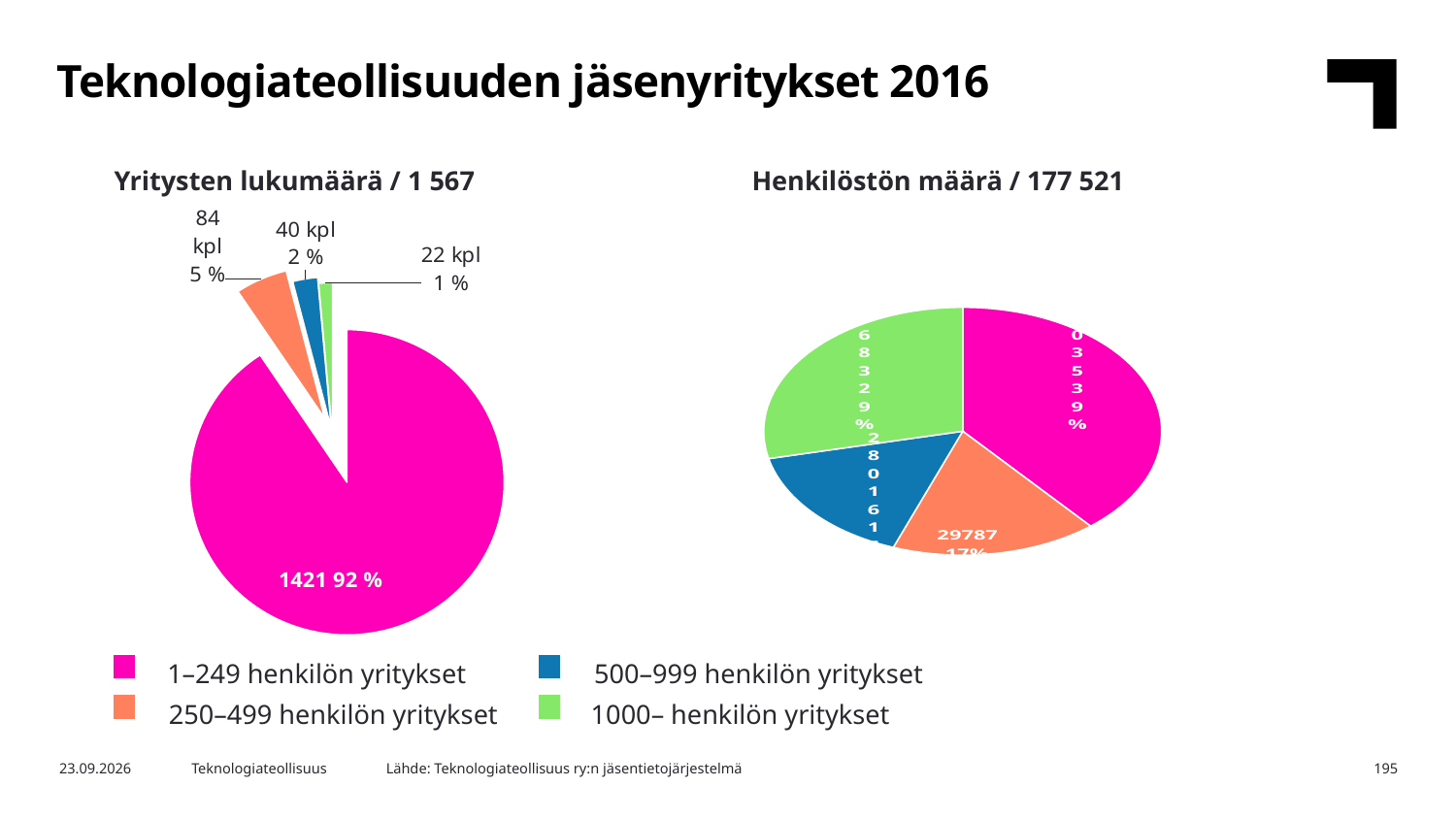
How many slices does the left chart 'Yritysten lukumäärä / 1 567' have? 4 In the left chart 'Yritysten lukumäärä / 1 567', what share of the pie does the 1000– henkilön yritykset slice have? 1 % In the left chart 'Yritysten lukumäärä / 1 567', how many companies are in the 1–249 henkilön yritykset category? 1421 How many categories does the shared legend below the charts list? 4 In the left chart 'Yritysten lukumäärä / 1 567', which category has the smallest slice? 1000– henkilön yritykset In the left chart 'Yritysten lukumäärä / 1 567', what is the value for 500–999 henkilön yritykset? 40 kpl What type of chart is the left chart titled 'Yritysten lukumäärä / 1 567'? pie chart In the left chart 'Yritysten lukumäärä / 1 567', which category has the largest slice? 1–249 henkilön yritykset In the left chart 'Yritysten lukumäärä / 1 567', what share of the pie does the 1–249 henkilön yritykset slice have? 92 % In the right chart 'Henkilöstön määrä / 177 521', which category has the largest slice? 1–249 henkilön yritykset In the left chart 'Yritysten lukumäärä / 1 567', what is the value for 250–499 henkilön yritykset? 84 kpl In the left chart 'Yritysten lukumäärä / 1 567', what is the difference between the values for 250–499 and 500–999 henkilön yritykset? 44 kpl